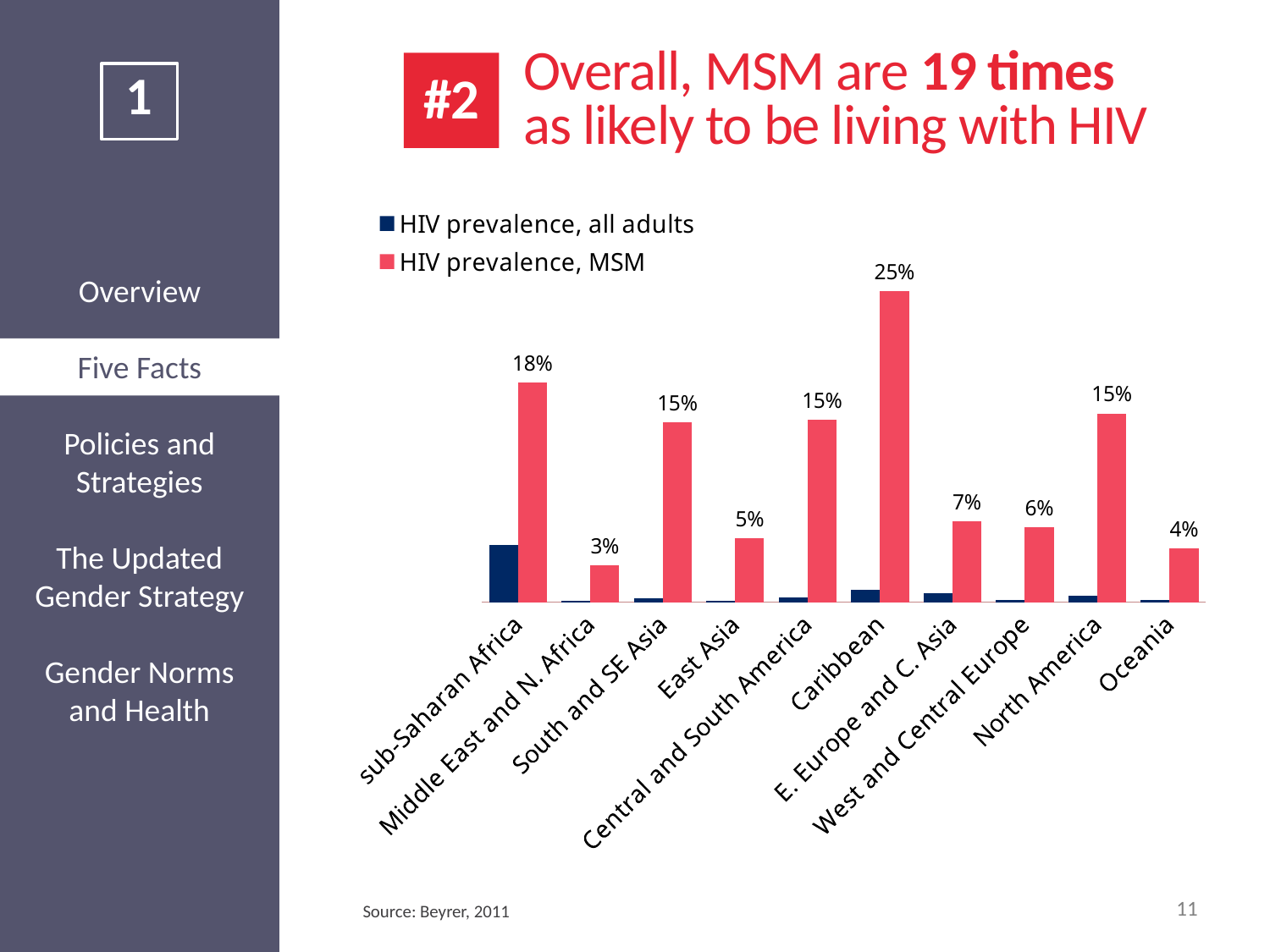
Which region has the highest HIV prevalence among MSM? Caribbean Which series is shown in red in the chart? HIV prevalence, MSM What is the HIV prevalence among MSM in the Caribbean? 25% Which region has the lowest HIV prevalence among MSM? Middle East and N. Africa What is the HIV prevalence among MSM in Oceania? 4% What kind of chart is shown on the slide? Bar chart What is the HIV prevalence among MSM in E. Europe and C. Asia? 7% How many regions are shown on the x axis of the chart? 10 What is the difference between the MSM HIV prevalence in the Caribbean and in sub-Saharan Africa? 7% What is the HIV prevalence among MSM in sub-Saharan Africa? 18% How many series does the chart's legend list? 2 Which is larger, the MSM HIV prevalence in East Asia or in West and Central Europe? West and Central Europe